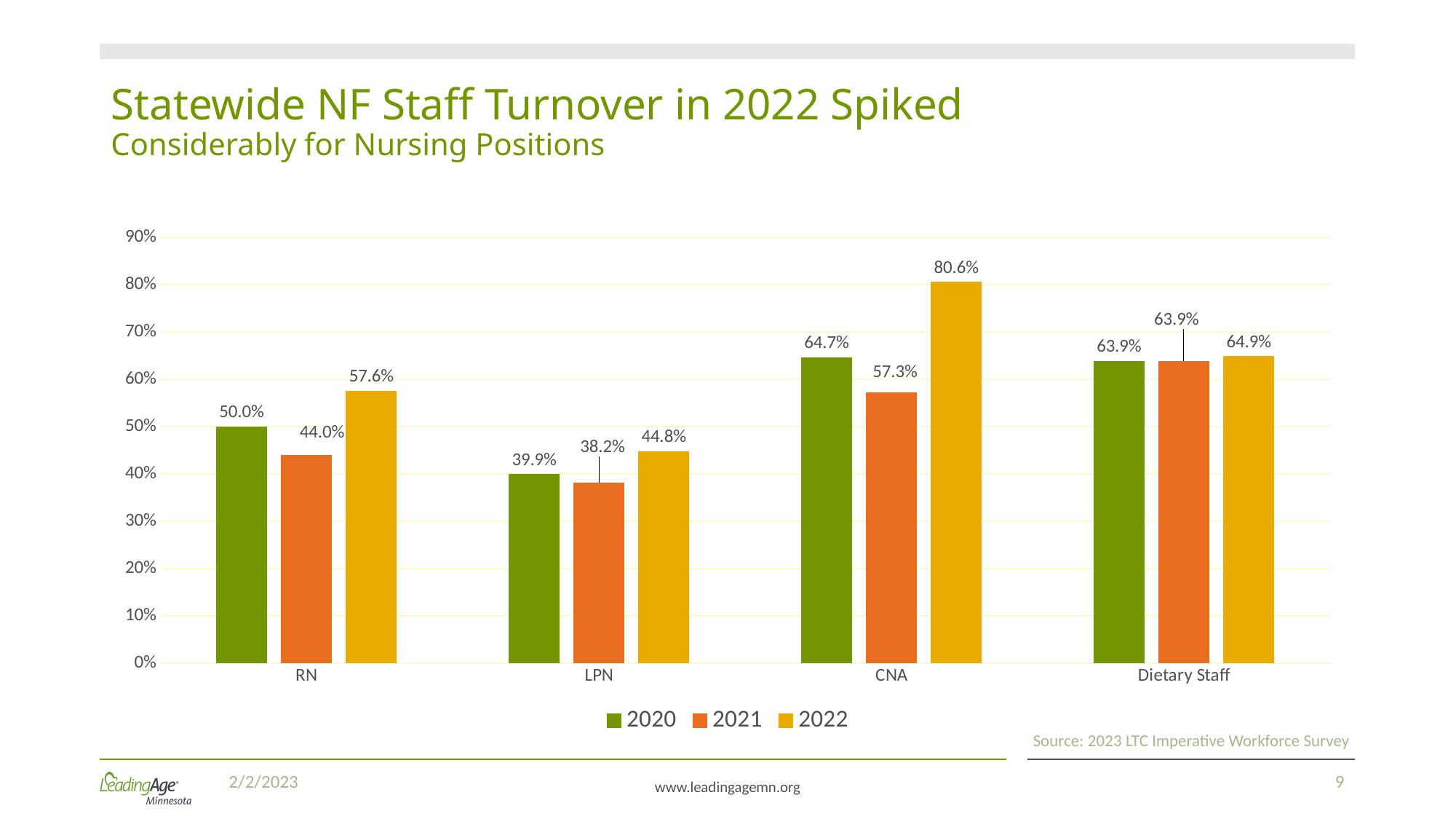
What kind of chart is shown on the slide? Bar chart Which position had the lowest 2021 turnover rate? LPN Which is larger, the 2020 turnover rate for RN or the 2020 turnover rate for CNA? CNA How many series does the legend list? 3 How many positions are shown on the x axis? 4 What was the 2021 turnover rate for RN? 44.0% What is the difference between the 2022 and 2021 turnover rates for CNA? 23.3% What was the 2020 turnover rate for LPN? 39.9% What is the source cited for the chart? 2023 LTC Imperative Workforce Survey What was the 2022 turnover rate for Dietary Staff? 64.9% What was the 2022 turnover rate for CNA? 80.6% Which position had the highest 2022 turnover rate? CNA